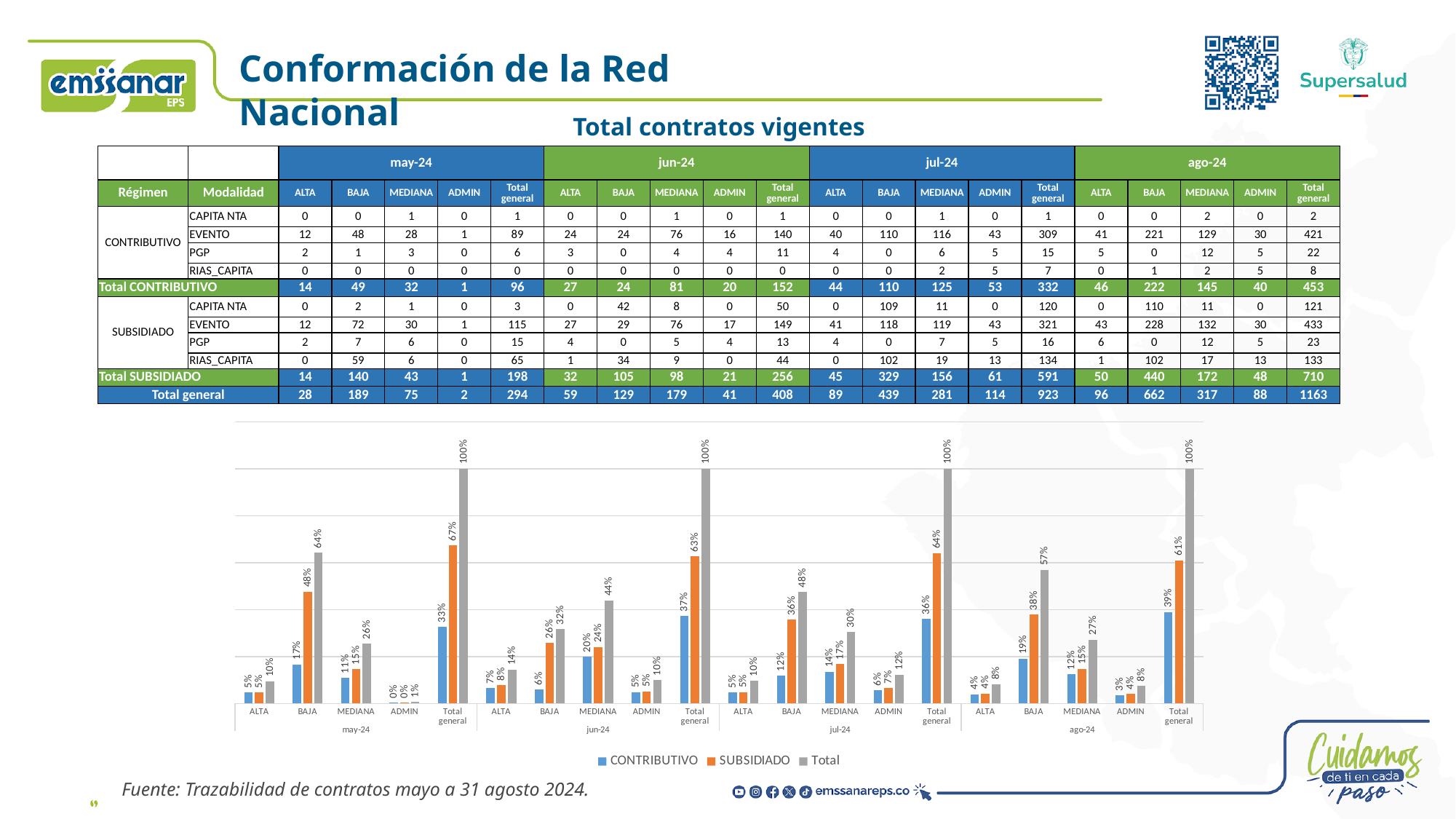
Which series is shown in orange in the chart legend? SUBSIDIADO What is the CONTRIBUTIVO value for MEDIANA in jun-24 on the chart? 20% How many series does the chart legend list? 3 What is the SUBSIDIADO value for BAJA in may-24 on the chart? 48% On the chart, is the CONTRIBUTIVO value for Total general larger in ago-24 or in may-24? ago-24 Which month has the highest Total value for BAJA on the chart? may-24 What is the difference between the SUBSIDIADO and CONTRIBUTIVO values for BAJA in jul-24 on the chart? 24% What is the CONTRIBUTIVO value for ADMIN in ago-24 on the chart? 3% What is the SUBSIDIADO value for Total general in jul-24 on the chart? 64% What is the Total value for BAJA in ago-24 on the chart? 57% What type of chart is shown below the table? bar chart Which category in may-24 has the lowest Total value on the chart? ADMIN